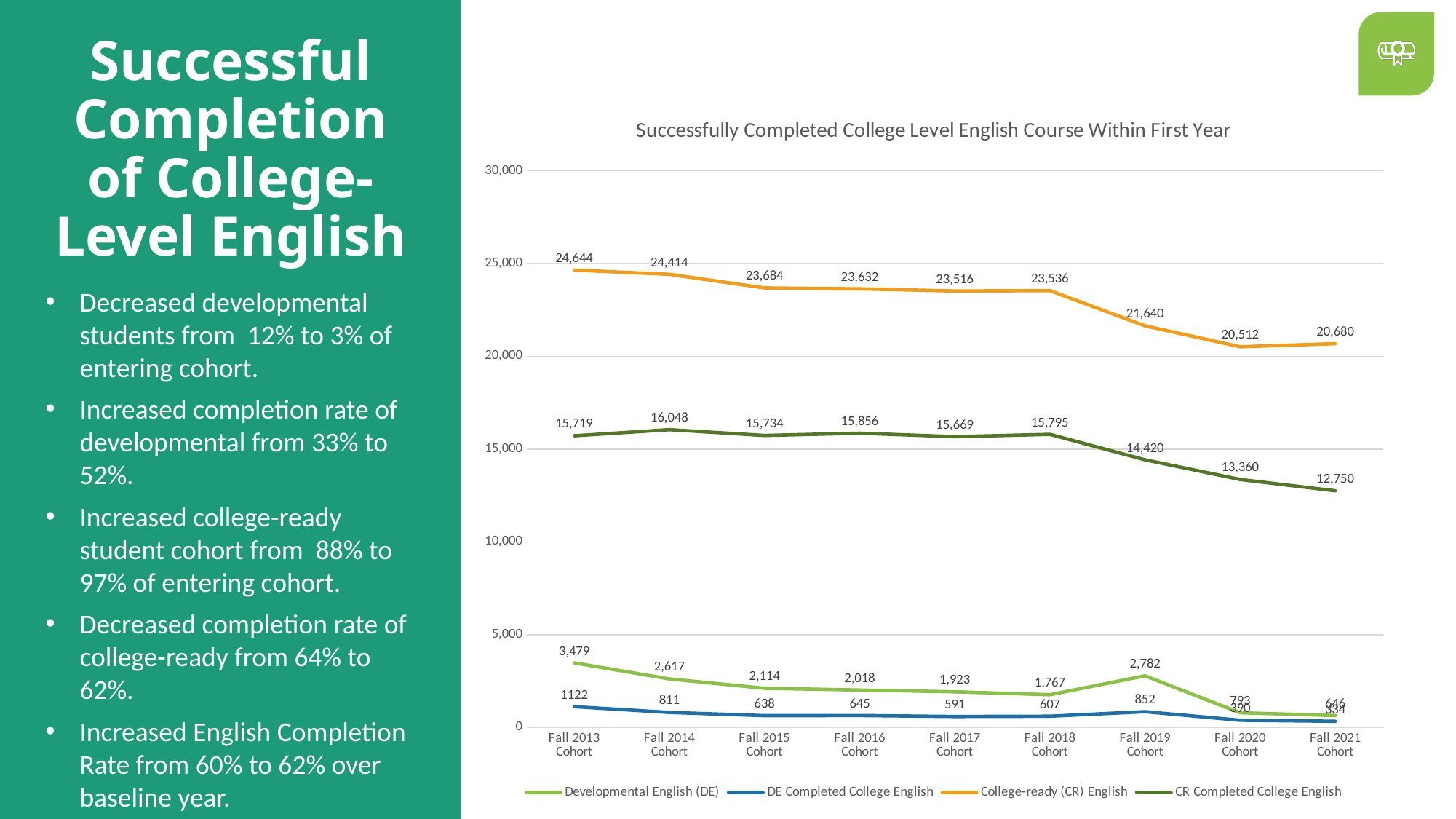
What is the value for DE Completed College English for the Fall 2013 Cohort? 1122 How many series does the legend list? 4 What is the value for CR Completed College English for the Fall 2019 Cohort? 14,420 What is the value for Developmental English (DE) for the Fall 2019 Cohort? 2,782 What is the difference between the College-ready (CR) English values for the Fall 2013 Cohort and the Fall 2021 Cohort? 3,964 Which cohort has the highest value for CR Completed College English? Fall 2014 Cohort Is the value for College-ready (CR) English for the Fall 2018 Cohort greater or less than 20,000? greater What is the title of the chart? Successfully Completed College Level English Course Within First Year What type of chart is shown on the slide? line chart Which cohort has the lowest value for College-ready (CR) English? Fall 2020 Cohort What is the value for College-ready (CR) English for the Fall 2013 Cohort? 24,644 How many cohorts are plotted along the x axis? 9